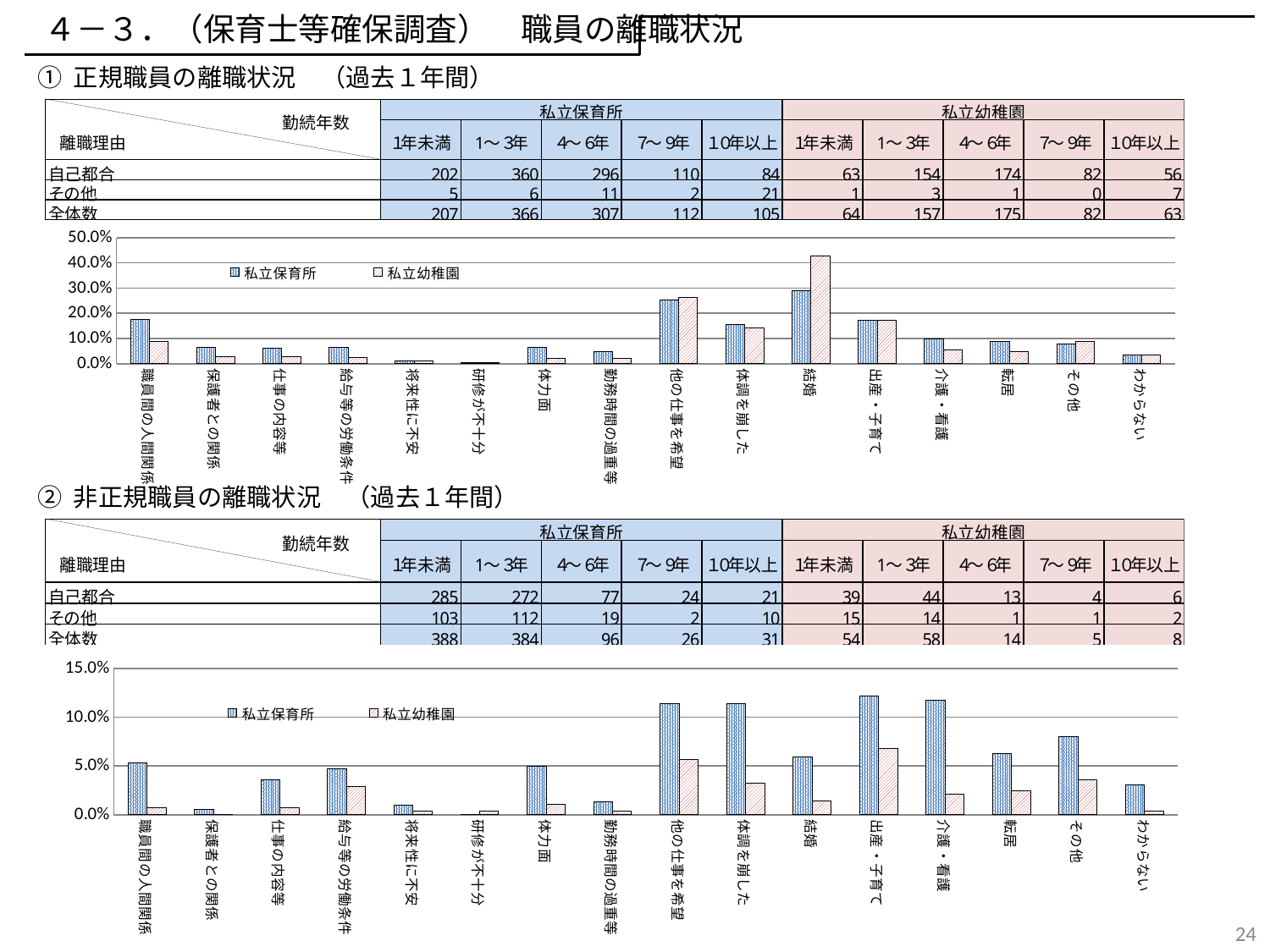
In the upper chart (① 正規職員の離職状況), how many series does the legend list? 2 In the lower chart (② 非正規職員の離職状況), for 職員間の人間関係, which series has the larger value, 私立保育所 or 私立幼稚園? 私立保育所 In the upper chart (① 正規職員の離職状況), is the value for 私立保育所 at 職員間の人間関係 greater or less than 10.0%? greater In the lower chart (② 非正規職員の離職状況), what is the highest value shown on the y axis? 15.0% In the upper chart (① 正規職員の離職状況), which category has the highest value for 私立保育所? 結婚 In the upper chart (① 正規職員の離職状況), what kind of chart is used? bar chart In the upper chart (① 正規職員の離職状況), for 結婚, which series has the larger value, 私立保育所 or 私立幼稚園? 私立幼稚園 In the upper chart (① 正規職員の離職状況), is the value for 私立幼稚園 at 結婚 greater or less than 30.0%? greater In the lower chart (② 非正規職員の離職状況), which category has the highest value for 私立幼稚園? 出産・子育て In the upper chart (① 正規職員の離職状況), which category has the highest value for 私立幼稚園? 結婚 In the lower chart (② 非正規職員の離職状況), is the value for 私立保育所 at 他の仕事を希望 greater or less than 10.0%? greater In the upper chart (① 正規職員の離職状況), how many reason categories are shown on the x axis? 16